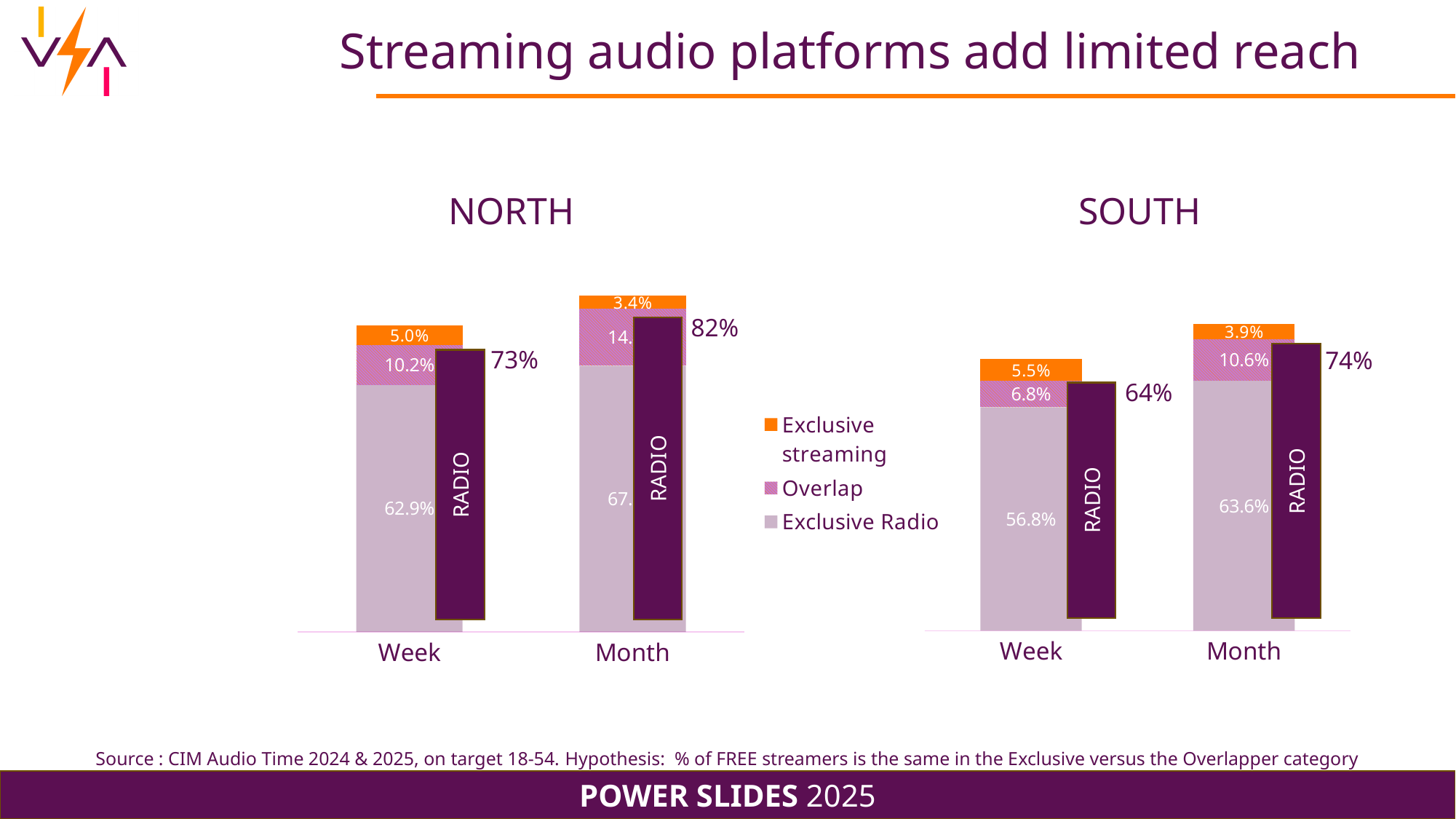
In the NORTH chart, what is the Exclusive streaming value for Week? 5.0% In the SOUTH chart, what is the total of the stacked bar for Week (Exclusive streaming + Overlap + Exclusive Radio)? 69.1% How many series does the legend list for the charts? 3 In the SOUTH chart, what is the Overlap value for Month? 10.6% Which is larger: the Week Exclusive streaming value in the NORTH chart or in the SOUTH chart? SOUTH In the SOUTH chart, what is the difference between the Exclusive Radio values for Month and Week? 6.8 percentage points In the SOUTH chart, what is the Exclusive streaming value for Week? 5.5% In the NORTH chart, what is the Exclusive streaming value for Month? 3.4% In the NORTH chart, what is the Exclusive Radio value for Week? 62.9% In the SOUTH chart, what is the Exclusive Radio value for Week? 56.8% In the NORTH chart, what is the Overlap value for Week? 10.2% In the NORTH chart, what RADIO reach percentage is shown next to the Month bar? 82%